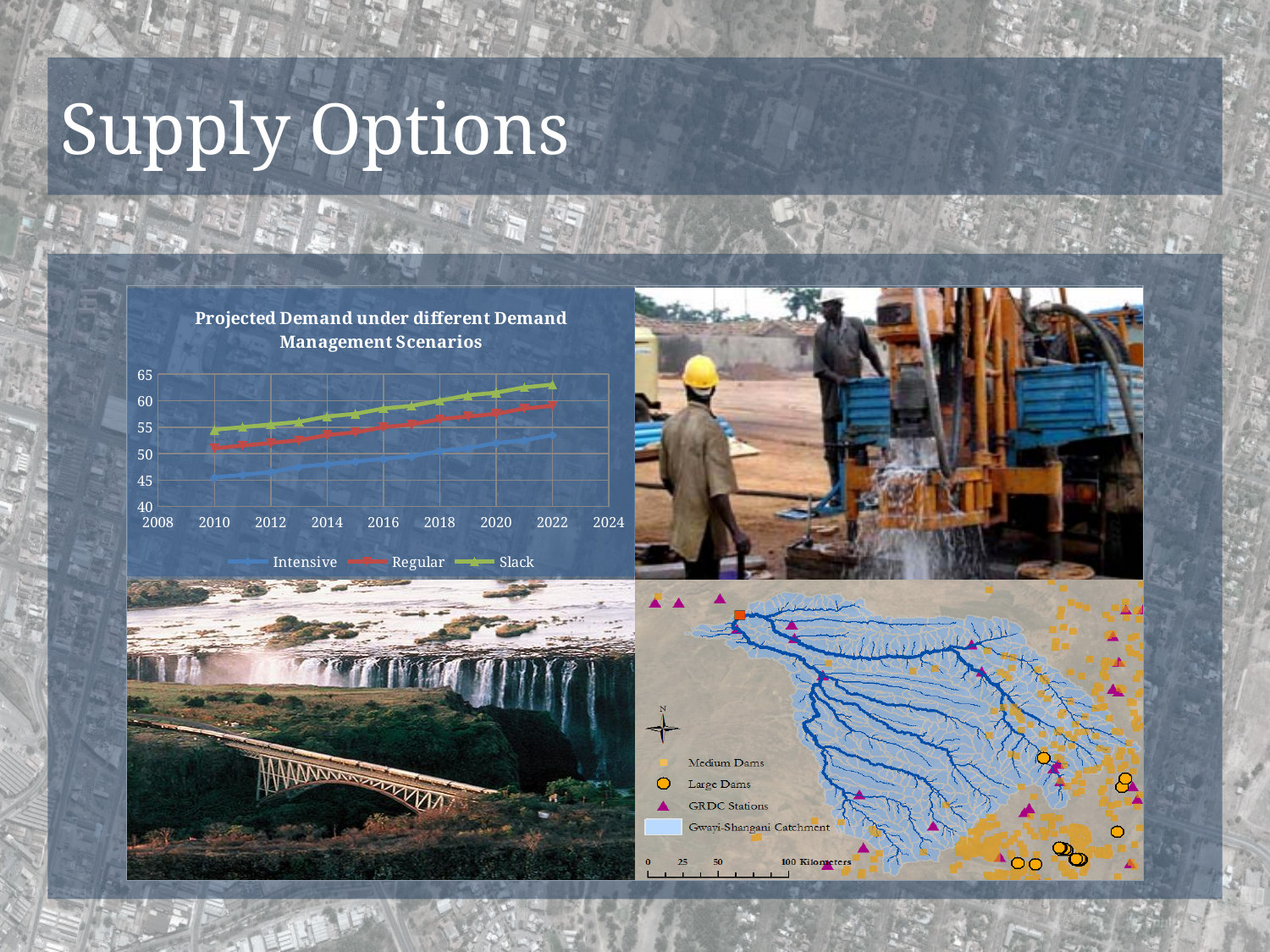
In the 'Projected Demand' chart, do the values for the Slack scenario rise or fall from 2010 to 2022? rise In the 'Projected Demand' chart, which scenario has the lowest projected demand in 2010? Intensive In the 'Projected Demand' chart, do the values for the Intensive scenario rise or fall over time? rise In the 'Projected Demand' chart, is the value for the Slack scenario in 2022 greater or less than 60? greater In the 'Projected Demand' chart, which scenario has the highest projected demand in 2022? Slack In the 'Projected Demand' chart, which is larger in 2016: the Slack value or the Intensive value? Slack What are the three scenarios listed in the legend of the 'Projected Demand' chart? Intensive, Regular, Slack In the 'Projected Demand' chart, is the value for the Intensive scenario in 2010 greater or less than 50? less In the 'Projected Demand' chart, is the value for the Regular scenario in 2010 greater or less than 50? greater What kind of chart is 'Projected Demand under different Demand Management Scenarios'? line chart What is the title of the line chart on the slide? Projected Demand under different Demand Management Scenarios How many series does the legend of the 'Projected Demand' chart list? 3